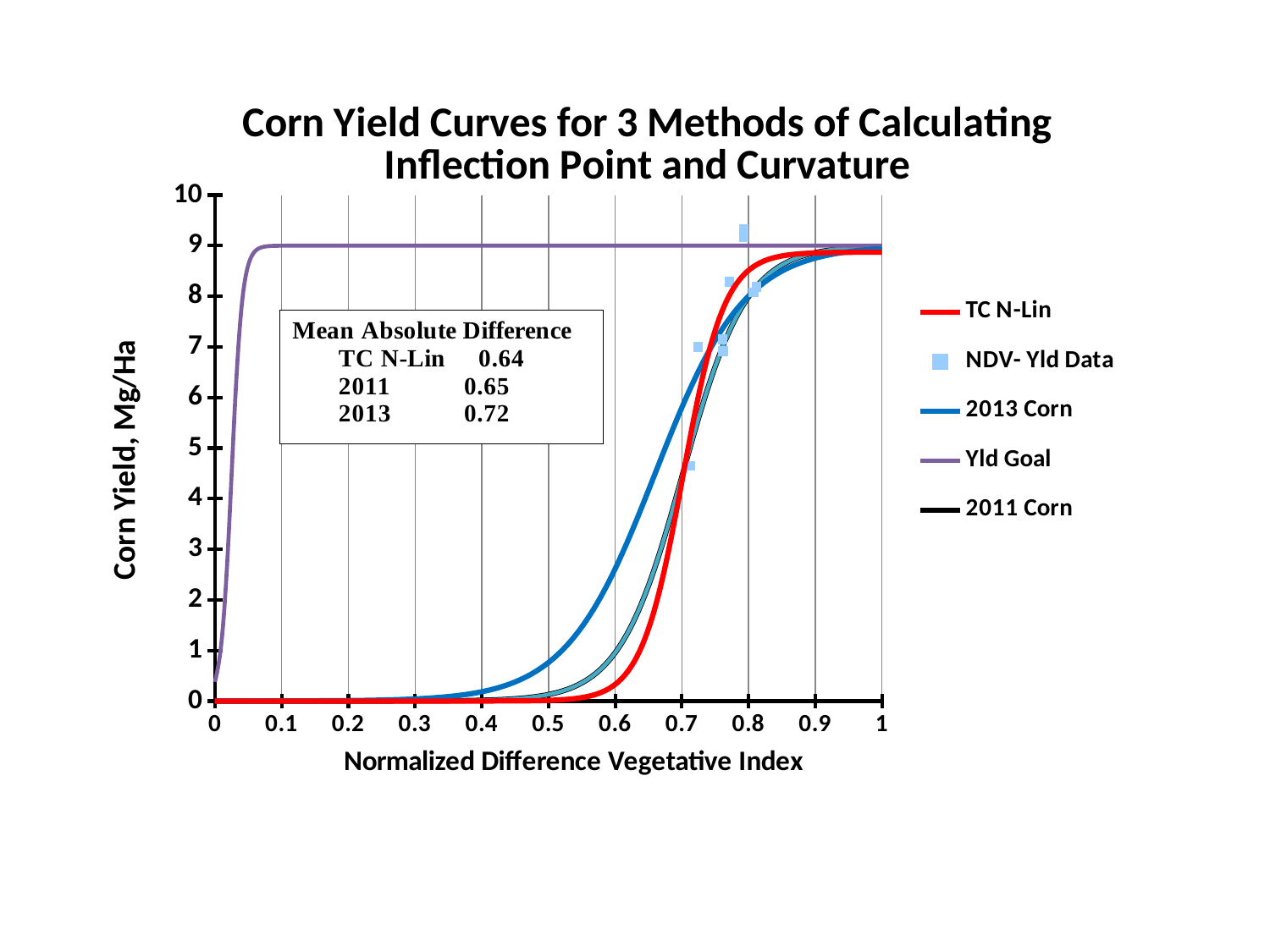
What is the difference between the Mean Absolute Difference for 2013 and for TC N-Lin? 0.08 Do the corn yield curves rise or fall as the Normalized Difference Vegetative Index increases? rise Which method has the highest Mean Absolute Difference in the text box? 2013 What is the label of the y axis? Corn Yield, Mg/Ha What kind of chart is shown on the slide? line chart According to the Mean Absolute Difference box, what is the value for TC N-Lin? 0.64 What is the title of the chart? Corn Yield Curves for 3 Methods of Calculating Inflection Point and Curvature At a Normalized Difference Vegetative Index of 0.6, which curve is higher, 2013 Corn or TC N-Lin? 2013 Corn According to the Mean Absolute Difference box, what is the value for 2013? 0.72 Which method has the lowest Mean Absolute Difference in the text box? TC N-Lin How many series does the legend list? 5 At a Normalized Difference Vegetative Index of 0.6, is the 2013 Corn curve greater or less than 1 Mg/Ha? greater